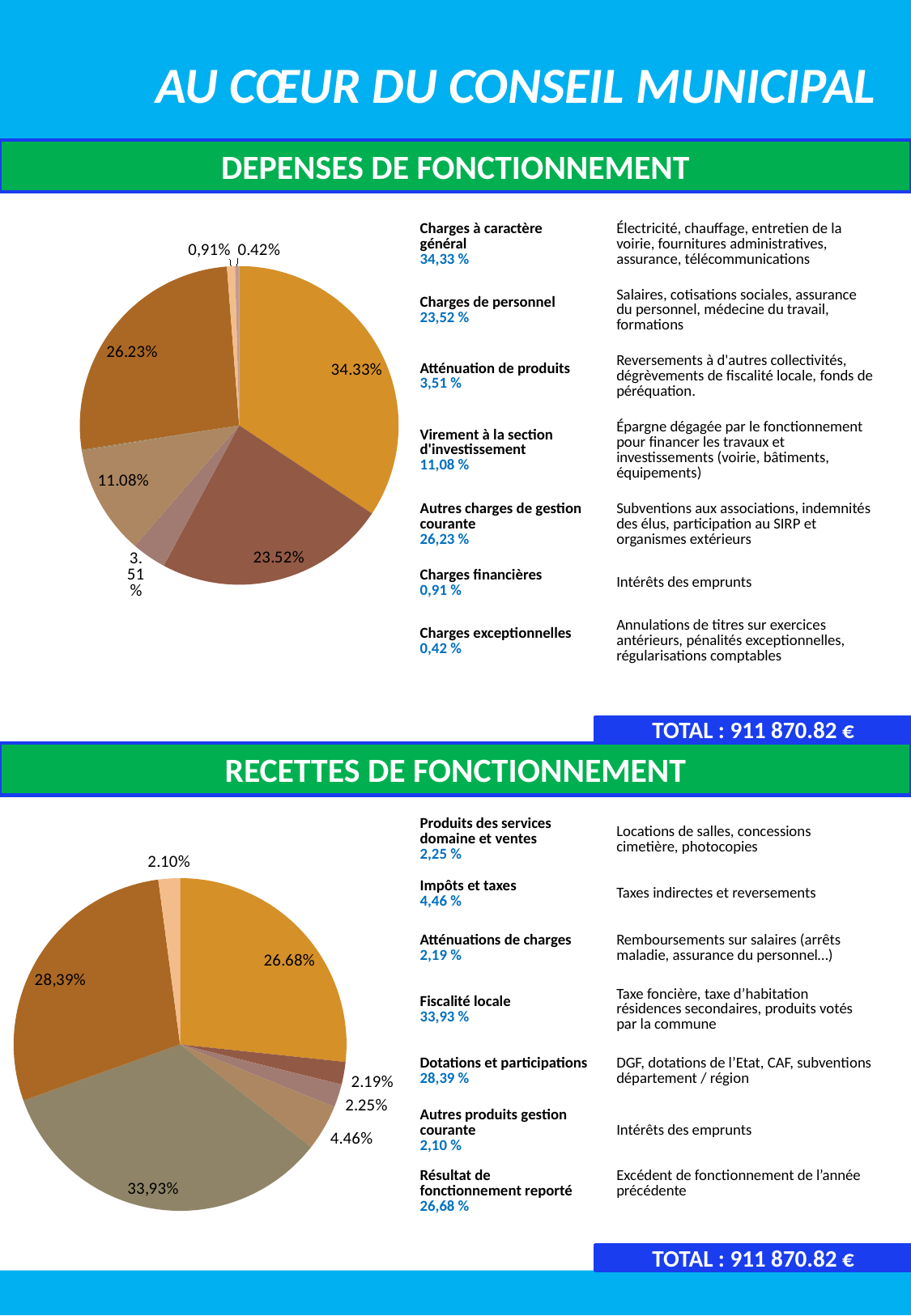
In the RECETTES DE FONCTIONNEMENT chart, what is the largest slice's value? 33,93% What kind of chart is used for DEPENSES DE FONCTIONNEMENT? Pie chart In the RECETTES DE FONCTIONNEMENT chart, how many slices does the pie have? 7 In the DEPENSES DE FONCTIONNEMENT chart, what is the difference between the 34.33% slice and the 23.52% slice? 10.81% In the RECETTES DE FONCTIONNEMENT chart, which is larger: the 28,39% slice or the 26.68% slice? 28,39% In the DEPENSES DE FONCTIONNEMENT chart, what is the largest slice's value? 34.33% What total amount is shown below the RECETTES DE FONCTIONNEMENT chart? 911 870.82 € In the RECETTES DE FONCTIONNEMENT chart, what is the smallest slice's value? 2.10% In the DEPENSES DE FONCTIONNEMENT chart, which is larger: the 26.23% slice or the 23.52% slice? 26.23% In the DEPENSES DE FONCTIONNEMENT chart, what is the value of the slice labelled 11.08%, which corresponds to Virement à la section d'investissement? 11.08%